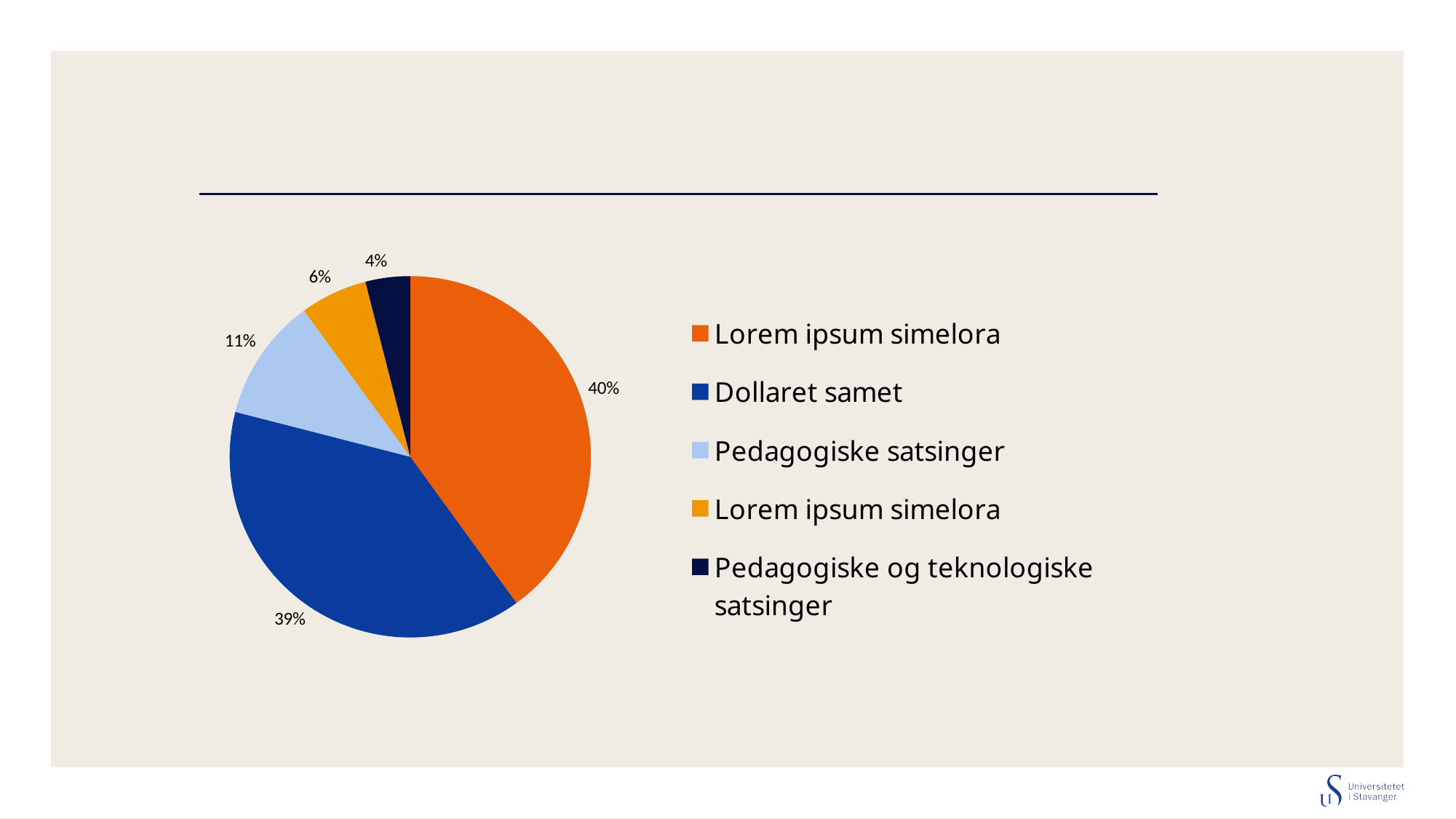
What share of the pie does the orange slice labelled Lorem ipsum simelora (first legend entry) have? 40% How many entries does the legend list? 5 How many slices does the pie chart have? 5 What is the difference in percentage points between Dollaret samet and Pedagogiske satsinger? 28 What kind of chart is shown on the slide? pie chart What colour is the slice for Dollaret samet? blue What share of the pie does the yellow slice labelled Lorem ipsum simelora (fourth legend entry) have? 6% What share of the pie does Pedagogiske og teknologiske satsinger have? 4% What share of the pie does Pedagogiske satsinger have? 11% Which category has the smallest slice of the pie? Pedagogiske og teknologiske satsinger What share of the pie does Dollaret samet have? 39% Which is larger, the share for Pedagogiske satsinger or the share for Pedagogiske og teknologiske satsinger? Pedagogiske satsinger